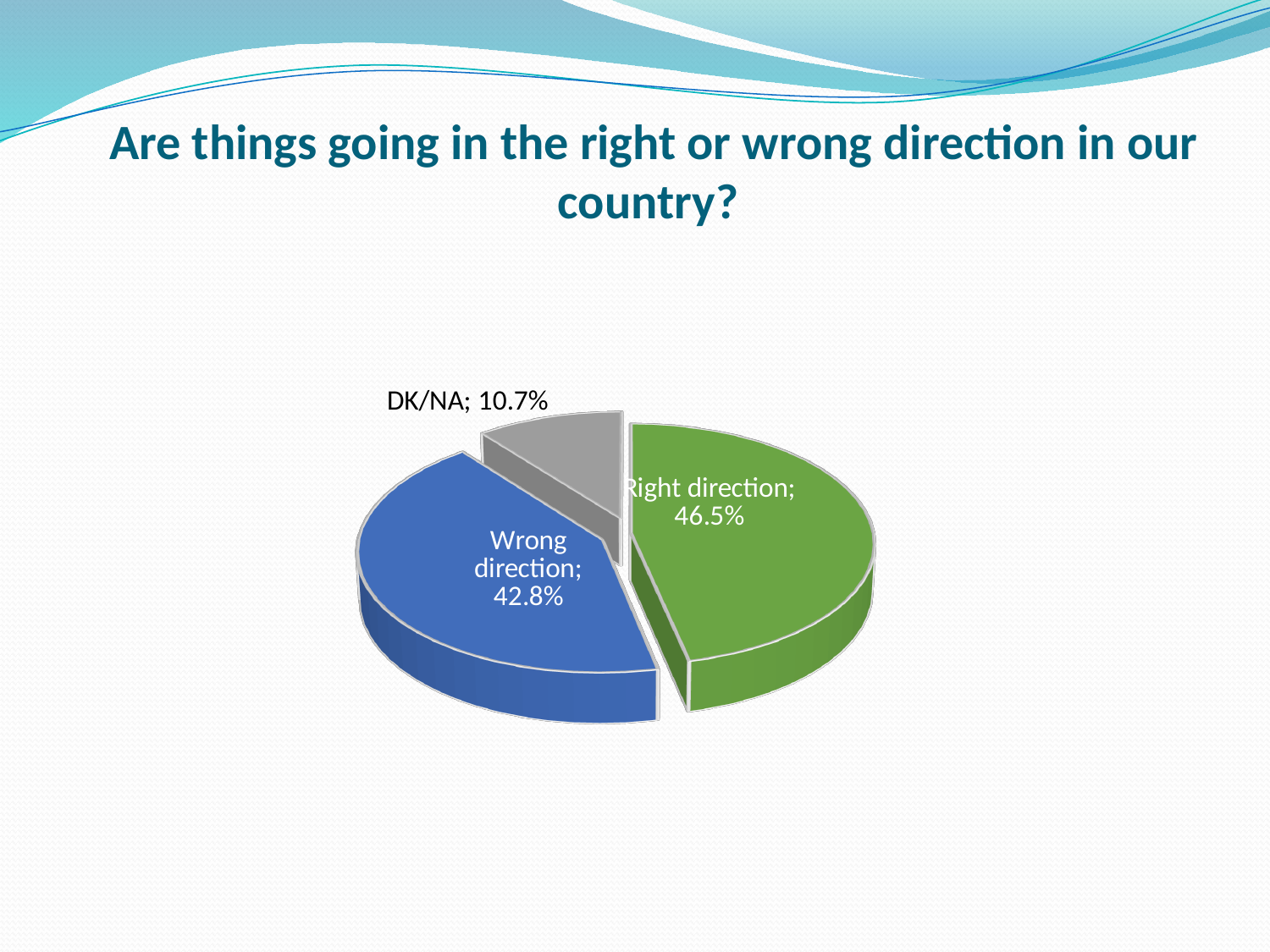
What kind of chart is shown on the slide? Pie chart Which response has the largest share of the pie? Right direction What is the difference in percentage points between the Right direction and Wrong direction slices? 3.7 What percentage of respondents said things are going in the wrong direction? 42.8% How many slices does the pie chart have? 3 What percentage of respondents said things are going in the right direction? 46.5% What is the value shown for the DK/NA slice? 10.7% What colour is the Wrong direction slice? Blue Which is larger, the Wrong direction slice or the DK/NA slice? Wrong direction What is the title of the slide containing the chart? Are things going in the right or wrong direction in our country? Which response has the smallest share of the pie? DK/NA What is the difference in percentage points between the Wrong direction and DK/NA slices? 32.1